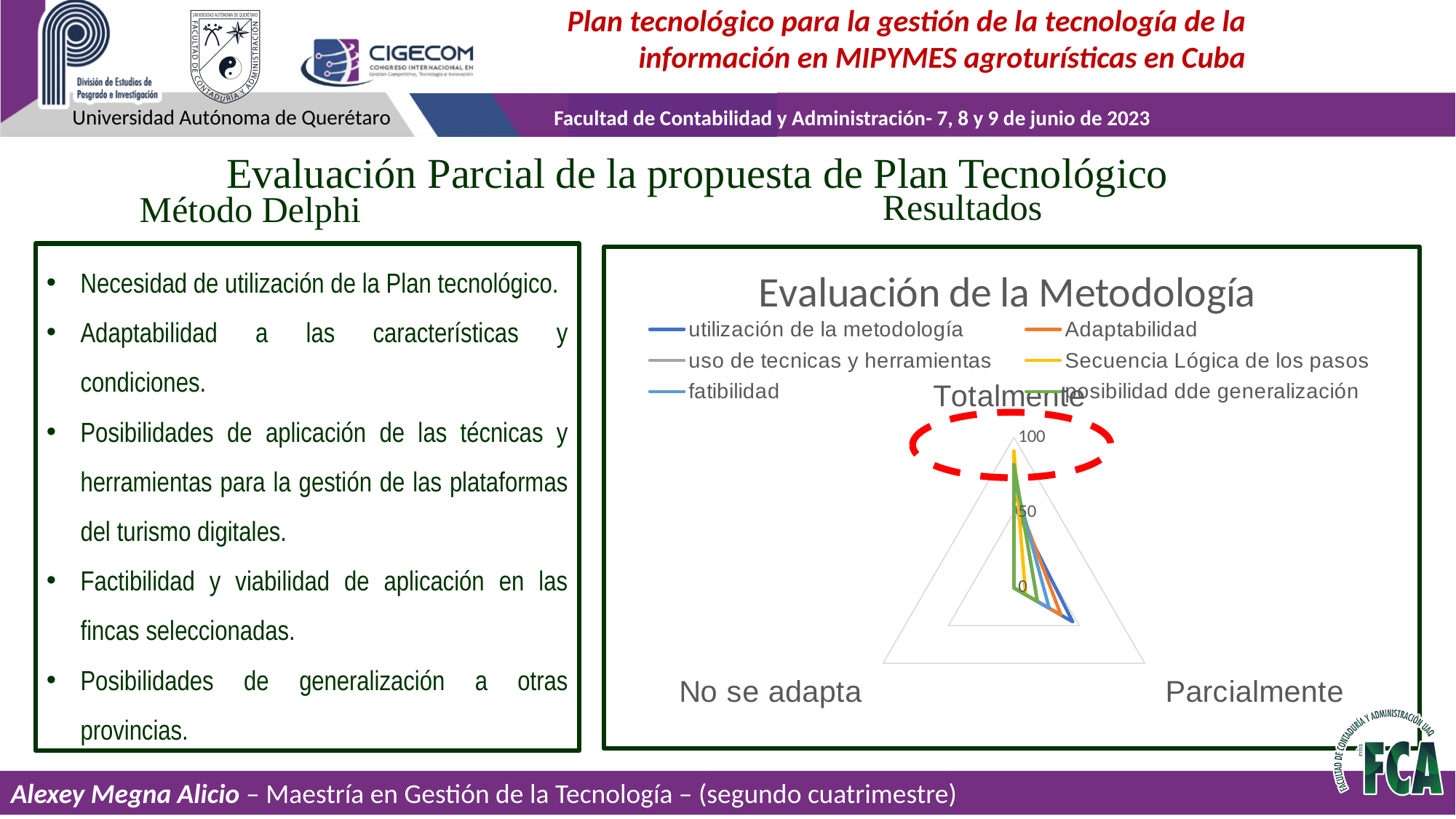
What kind of chart is shown under 'Resultados'? Radar chart What is the highest tick value shown on the radar chart's axis? 100 Is the value for 'posibilidad dde generalización' on the 'Totalmente' axis greater or less than 50? greater Is the value for 'Adaptabilidad' on the 'No se adapta' axis greater or less than 50? less On which category do the series have their lowest values? No se adapta On which category do all the series reach their highest values? Totalmente How many series does the chart legend list? 6 For 'Adaptabilidad', which is larger: the value on 'Totalmente' or on 'No se adapta'? Totalmente What is the title of the chart? Evaluación de la Metodología Which category is circled with a red dashed line on the chart? Totalmente How many categories (axes) does the radar chart have? 3